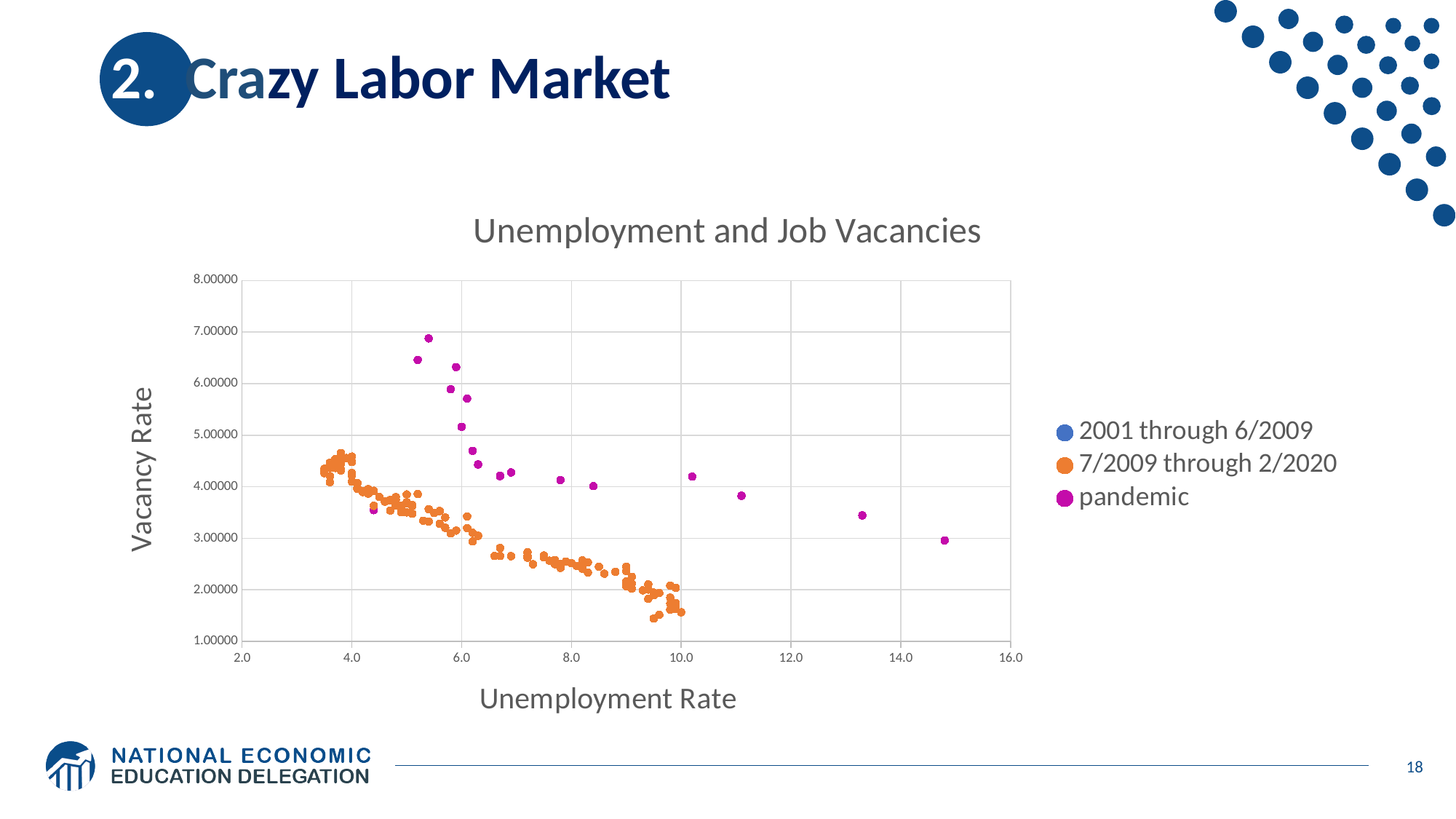
What kind of chart is shown on the slide? scatter chart Is the highest vacancy rate reached by the pandemic series greater or less than 6.00000? greater Which series contains the point with the highest unemployment rate, 7/2009 through 2/2020 or pandemic? pandemic What is the label of the horizontal axis of the chart? Unemployment Rate What is the maximum value shown on the horizontal axis of the chart? 16.0 Which series contains the point with the highest vacancy rate, 7/2009 through 2/2020 or pandemic? pandemic Is the highest vacancy rate reached by the 7/2009 through 2/2020 series greater or less than 5.00000? less Is the vacancy rate of the 7/2009 through 2/2020 points near 10.0 unemployment greater or less than 2.00000? less How many series does the chart's legend list? 3 For the 7/2009 through 2/2020 series, does the vacancy rate rise or fall as the unemployment rate increases? fall What is the title of the chart? Unemployment and Job Vacancies